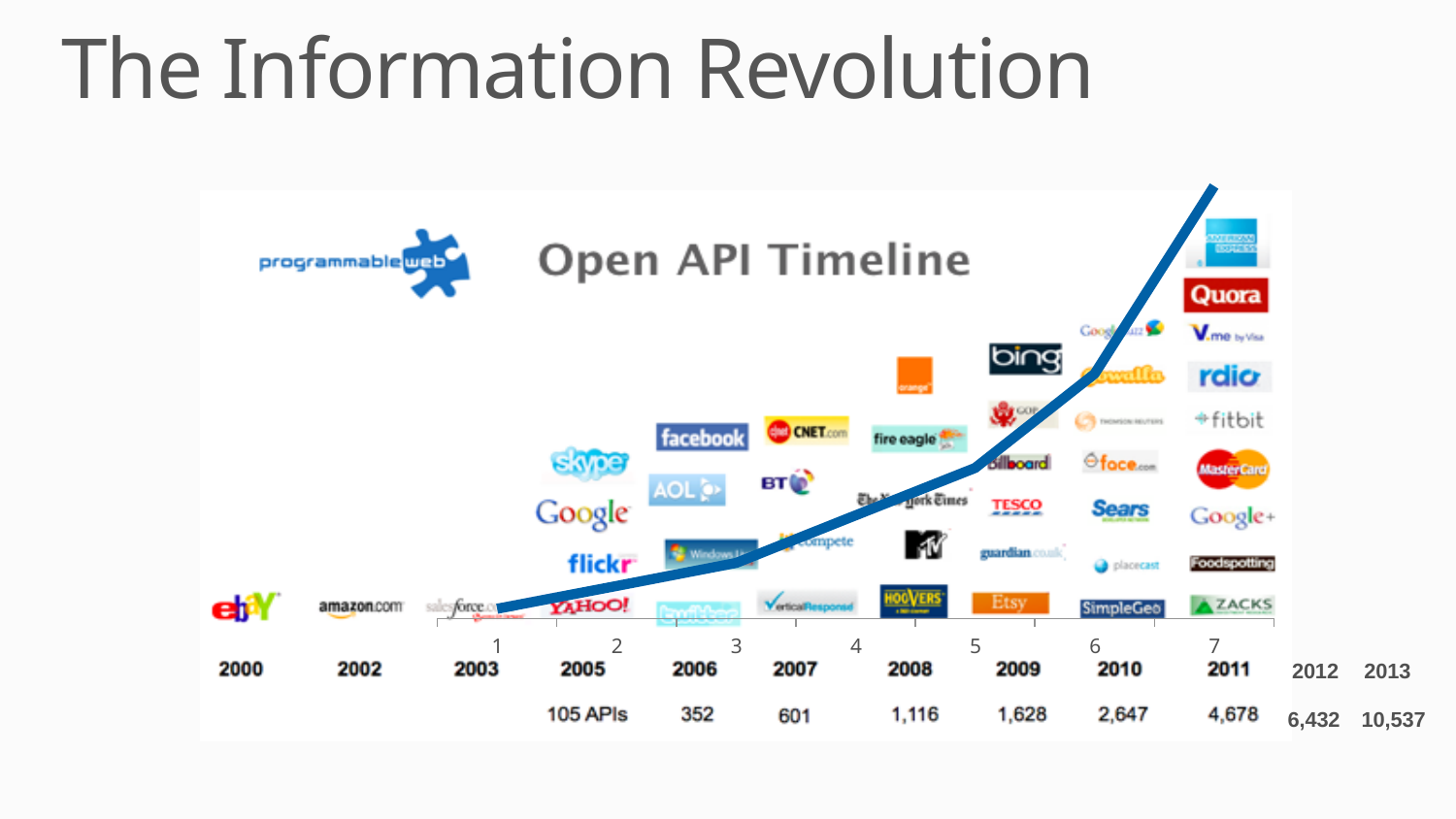
What is the title of the chart on the slide? Open API Timeline What is the number of APIs shown for 2013? 10,537 Does the number of APIs rise or fall over the years shown on the timeline? rise What is the number of APIs shown for 2011? 4,678 What is the difference in the number of APIs between 2011 and 2010? 2,031 What kind of chart is overlaid on the Open API Timeline? line chart What is the difference in the number of APIs between 2013 and 2012? 4,105 Which year has the highest number of APIs on the timeline? 2013 What is the number of APIs shown for 2008? 1,116 Which year has more APIs, 2009 or 2008? 2009 How many APIs are listed for 2005 on the Open API Timeline? 105 APIs Which year has the lowest number of APIs among those with a count printed? 2005